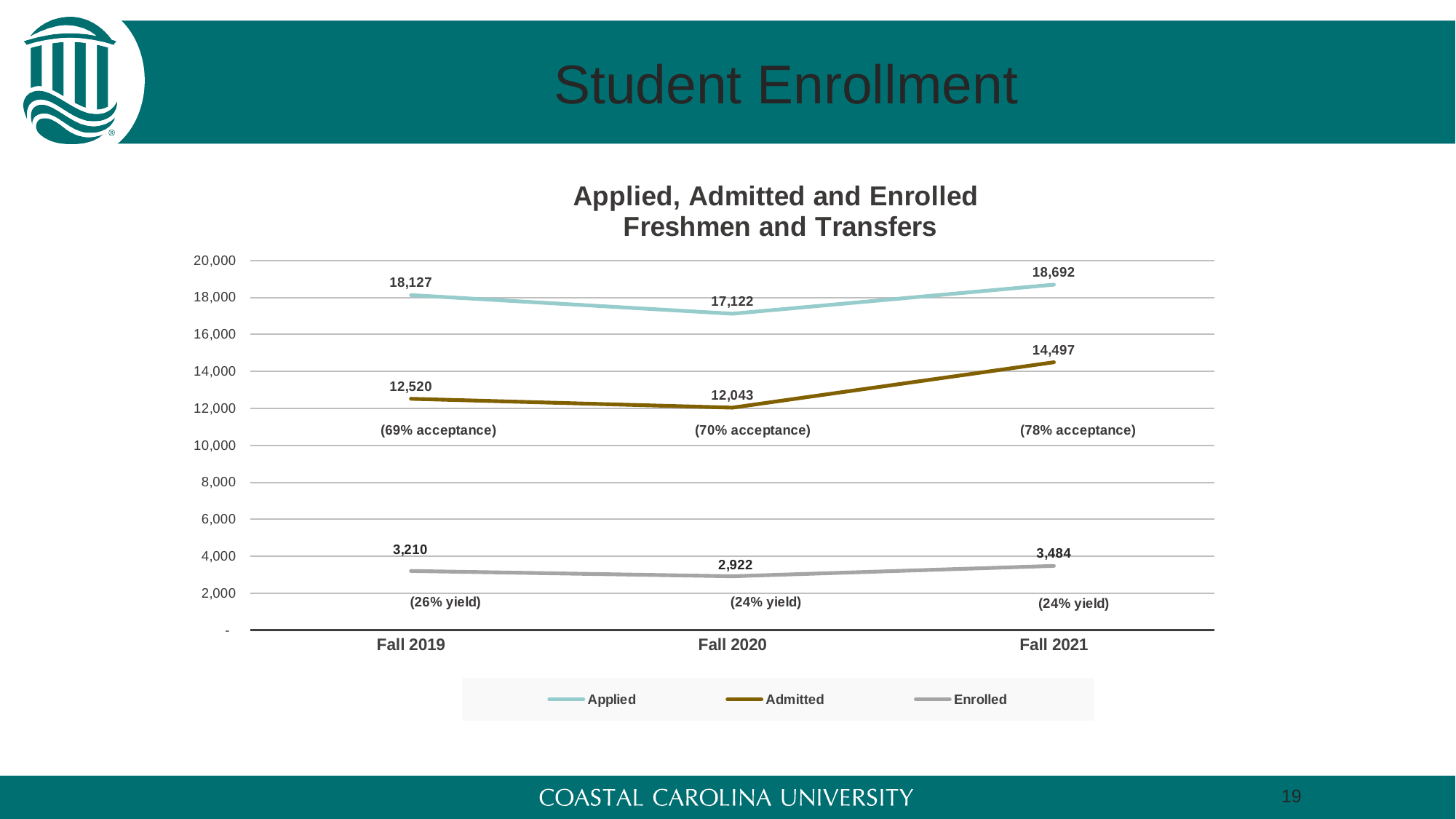
What is the number of Applied students in Fall 2020? 17,122 What acceptance rate is shown for Fall 2021? 78% acceptance Which is larger, Enrolled in Fall 2019 or Enrolled in Fall 2020? Fall 2019 What is the number of Admitted students in Fall 2021? 14,497 What is the difference between Applied and Admitted in Fall 2019? 5,607 In which term was the Enrolled value highest? Fall 2021 In which term was the Applied value lowest? Fall 2020 What is the number of Enrolled students in Fall 2019? 3,210 How many series does the legend list? 3 How much did the Admitted value increase from Fall 2020 to Fall 2021? 2,454 How many terms are shown on the x axis? 3 What kind of chart is shown on the slide? Line chart